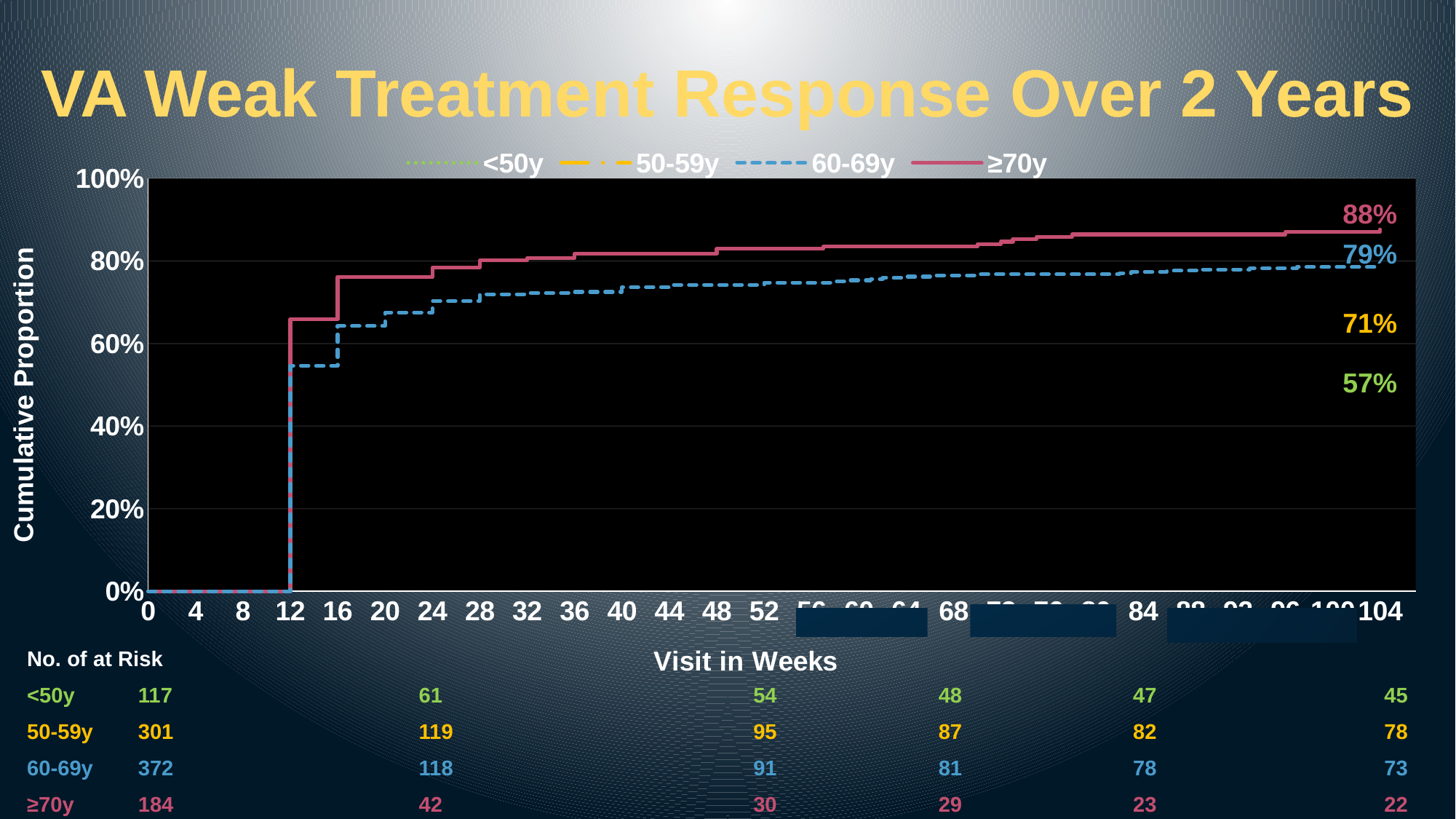
Does the ≥70y line rise or fall as the visit weeks increase? rise How many series does the legend list? 4 What is the cumulative proportion at 2 years for the 60-69y group? 79% What is the cumulative proportion at 2 years for the ≥70y group? 88% What is the title of the chart? VA Weak Treatment Response Over 2 Years Which age group has the lowest cumulative proportion at 2 years? <50y What is the difference between the 2-year cumulative proportions of the ≥70y and 60-69y groups? 9% Which age group has the highest cumulative proportion at 2 years? ≥70y What type of chart is shown on the slide? line chart What is the cumulative proportion at 2 years for the <50y group? 57% What is the cumulative proportion at 2 years for the 50-59y group? 71% Which group has a larger cumulative proportion at 2 years, 50-59y or <50y? 50-59y